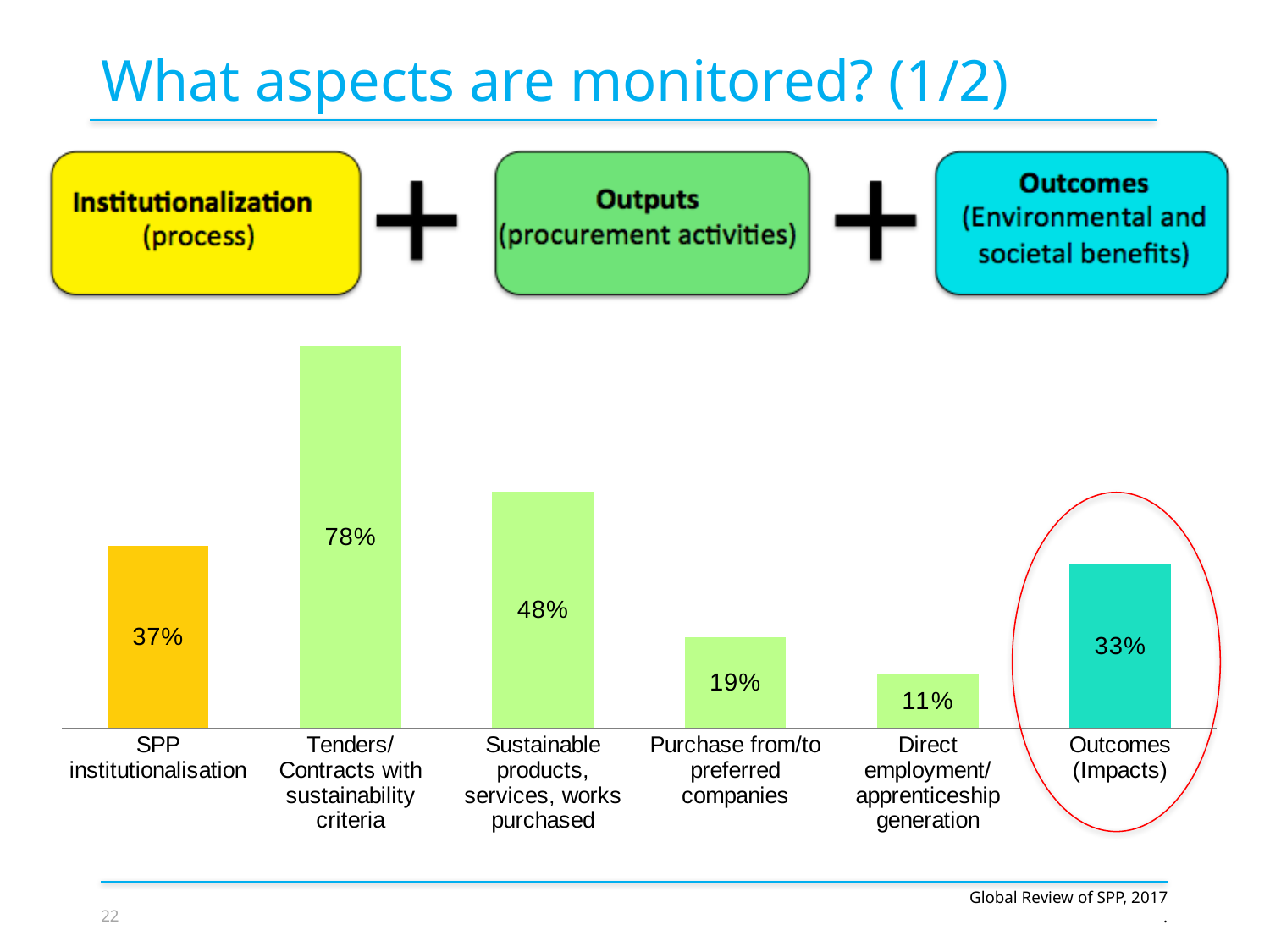
Which is larger, the value for Purchase from/to preferred companies or the value for Outcomes (Impacts)? Outcomes (Impacts) What is the difference between the values for SPP institutionalisation and Outcomes (Impacts)? 4% How many categories are shown in the chart? 6 Which category's bar is circled in red on the slide? Outcomes (Impacts) What is the difference between the values for Tenders/Contracts with sustainability criteria and Sustainable products, services, works purchased? 30% What is the value for Direct employment/apprenticeship generation? 11% What is the value for SPP institutionalisation? 37% What is the value for Outcomes (Impacts)? 33% What is the value for Tenders/Contracts with sustainability criteria? 78% What kind of chart is shown on the slide? Bar chart Which category has the lowest value? Direct employment/apprenticeship generation Which category has the highest value? Tenders/Contracts with sustainability criteria